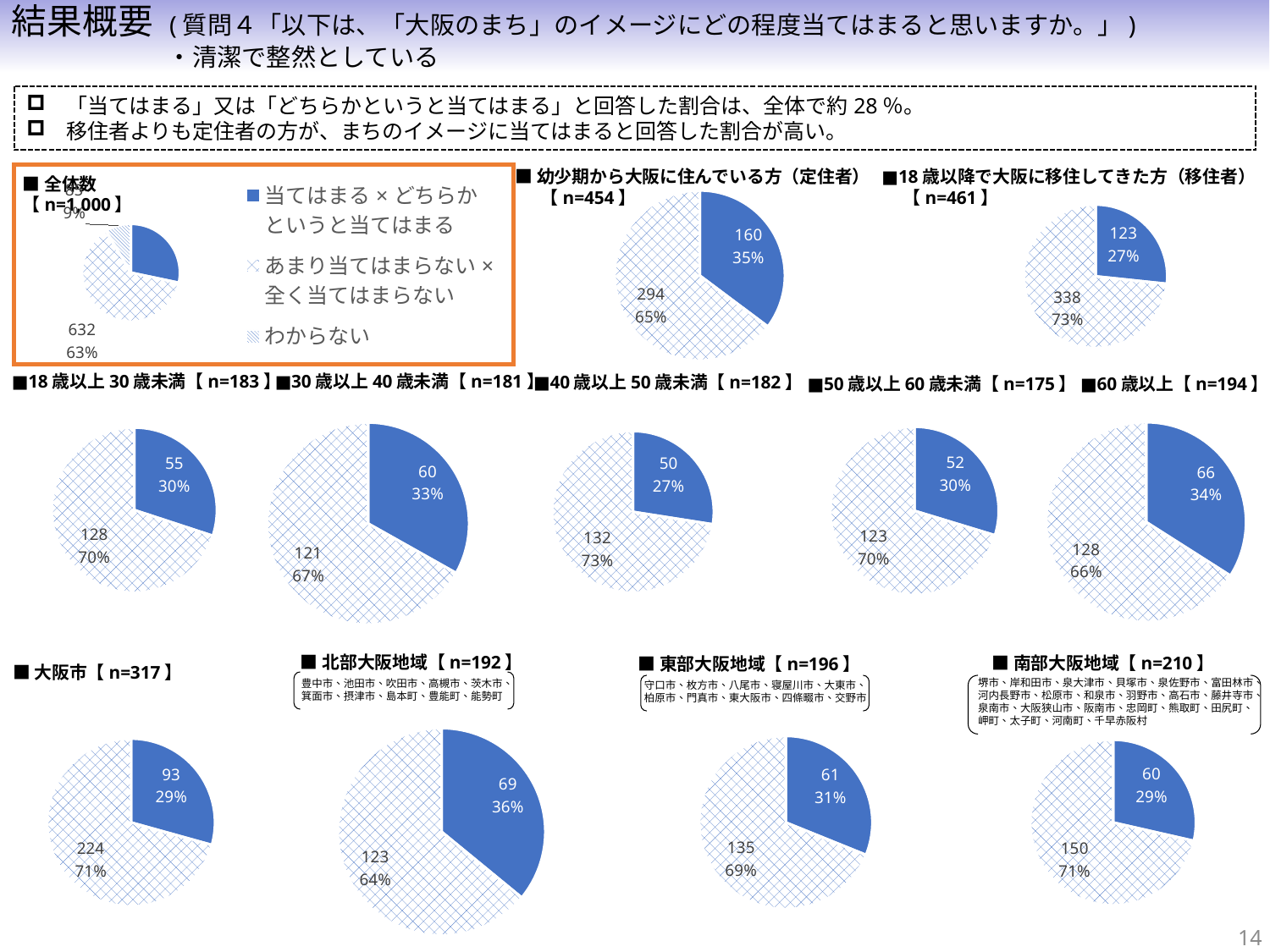
「全体数」の円グラフの凡例には、いくつの項目が示されていますか。 3 「北部大阪地域」と「南部大阪地域」では、「当てはまる × どちらかというと当てはまる」の割合が高いのはどちらですか。 北部大阪地域 「定住者」と「移住者」の円グラフで、「当てはまる × どちらかというと当てはまる」の割合の差は何ポイントですか。 8ポイント 「大阪市【n=317】」の円グラフで、「あまり当てはまらない × 全く当てはまらない」の人数は何人ですか。 224 「30歳以上40歳未満【n=181】」の円グラフで、「あまり当てはまらない × 全く当てはまらない」の割合は何%ですか。 67% このスライドのグラフはどの種類のグラフですか。 円グラフ 「北部大阪地域【n=192】」の円グラフで、「当てはまる × どちらかというと当てはまる」の割合は何%ですか。 36% 年代別の5つの円グラフのうち、「当てはまる × どちらかというと当てはまる」の割合が最も高いのはどの年代ですか。 60歳以上 「18歳以降で大阪に移住してきた方（移住者）」の円グラフで、「あまり当てはまらない × 全く当てはまらない」の人数は何人ですか。 338 年代別の5つの円グラフのうち、「当てはまる × どちらかというと当てはまる」の割合が最も低いのはどの年代ですか。 40歳以上50歳未満 「幼少期から大阪に住んでいる方（定住者）」の円グラフで、「当てはまる × どちらかというと当てはまる」の割合は何%ですか。 35% 「東部大阪地域【n=196】」の円グラフで、「当てはまる × どちらかというと当てはまる」の人数は何人ですか。 61